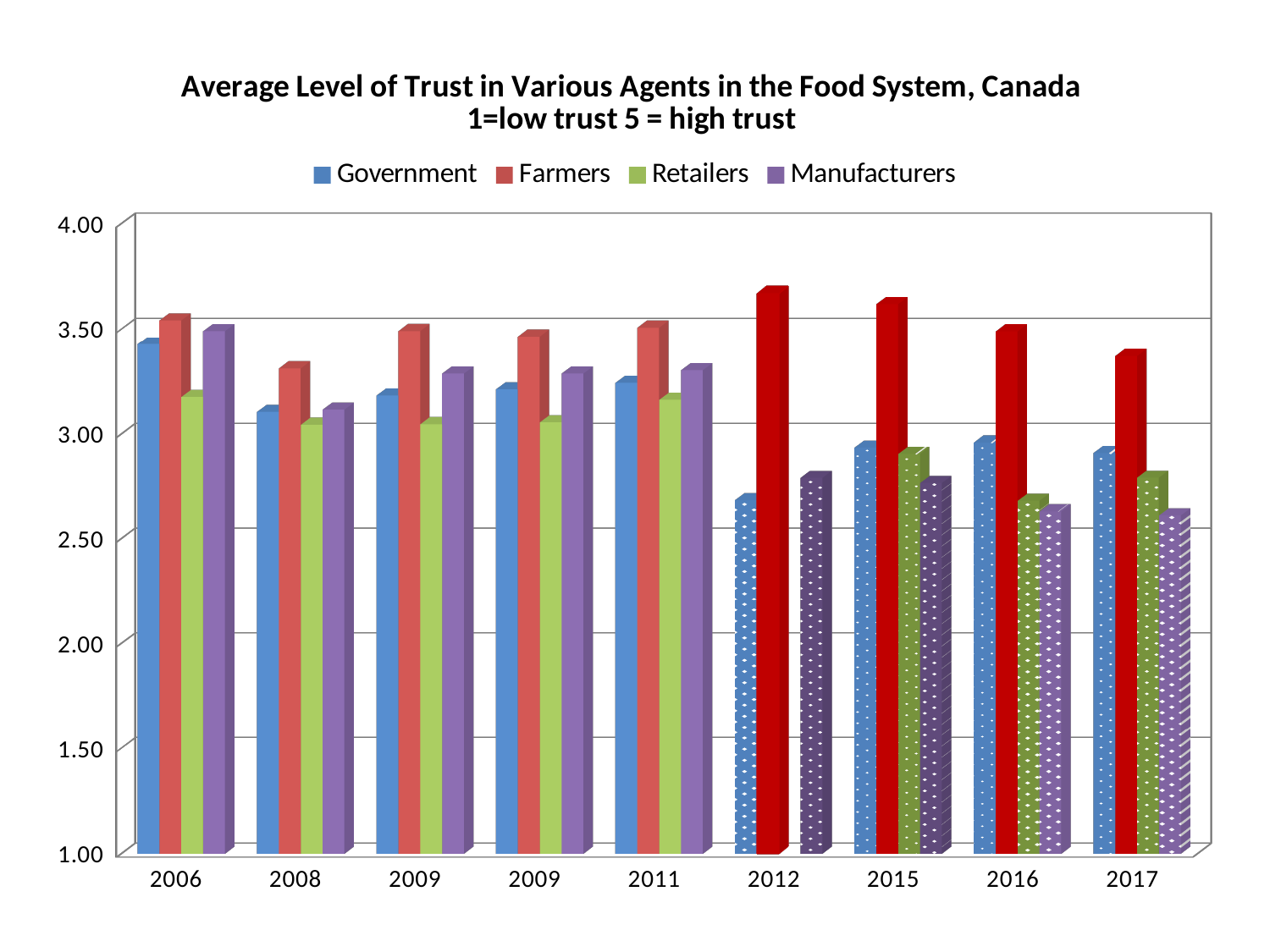
Is the value for Manufacturers in 2016 greater or less than 3.00? less What colour represents Farmers in the legend? Red Which is larger: the Farmers value in 2015 or the Farmers value in 2017? 2015 How many series does the legend list? 4 Which agent has the highest level of trust in 2012? Farmers Is the value for Government in 2012 greater or less than 3.00? less Which agent has the lowest level of trust in 2017? Manufacturers Is the value for Farmers in 2012 greater or less than 3.50? greater Does the Government value rise or fall from 2011 to 2012? Fall Which agent has the lowest level of trust in 2006? Retailers What kind of chart is shown on the slide? Bar chart How many year categories are shown along the x axis? 9